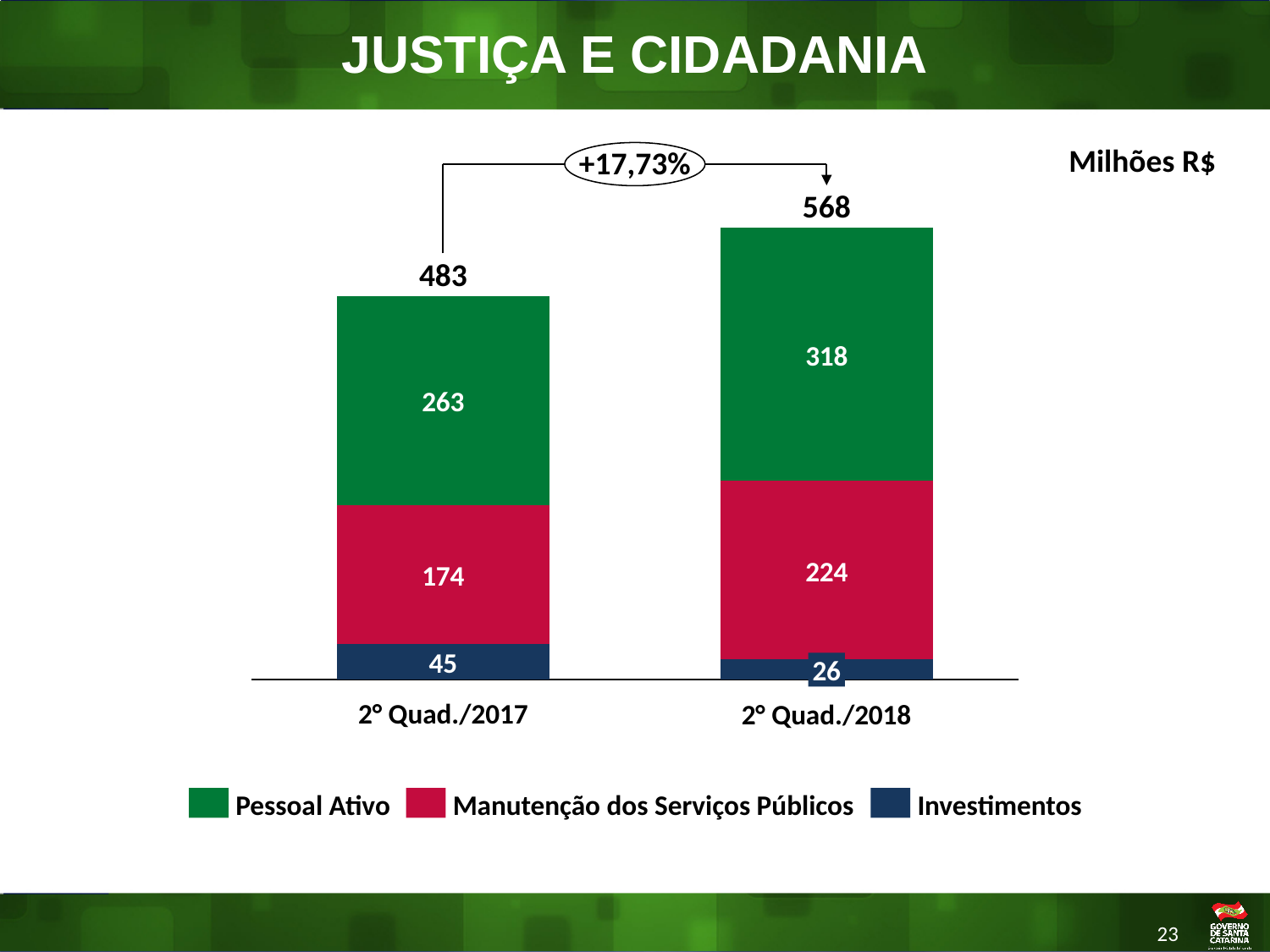
Which period has the higher value for Investimentos? 2° Quad./2017 What is the value for Investimentos in 2° Quad./2017? 45 What is the total of the stacked bar for 2° Quad./2017? 483 Which series has the lowest value in 2° Quad./2018? Investimentos What kind of chart is shown on the slide? Stacked bar chart What is the total of the stacked bar for 2° Quad./2018? 568 How many categories are shown on the x axis? 2 What is the difference between the Pessoal Ativo values for 2° Quad./2018 and 2° Quad./2017? 55 What is the value for Manutenção dos Serviços Públicos in 2° Quad./2018? 224 What is the value for Pessoal Ativo in 2° Quad./2017? 263 How many series does the legend list? 3 What percentage change is shown between the two bars? +17,73%